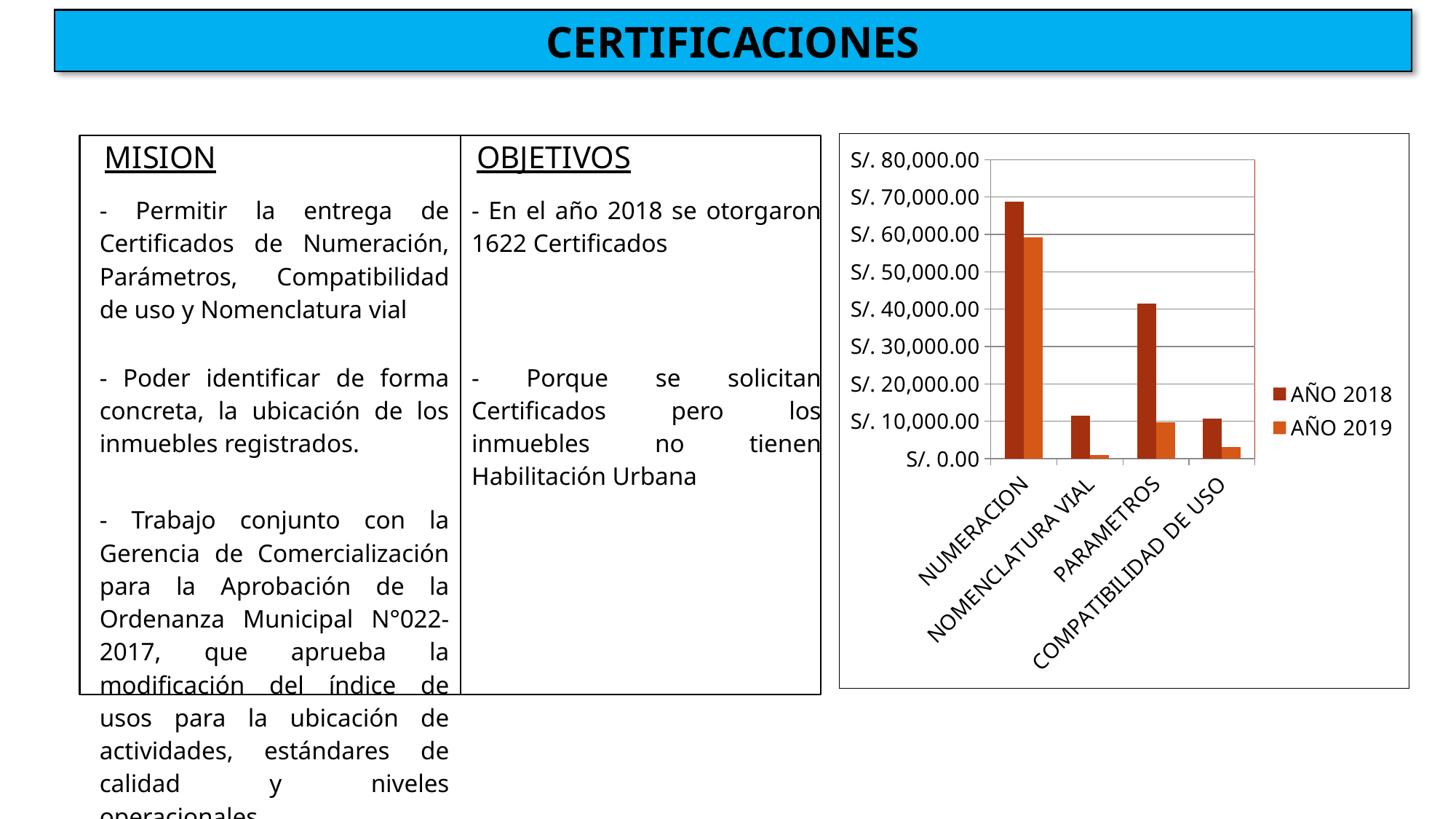
How many categories are shown on the x axis of the chart? 4 What are the two entries listed in the chart's legend? AÑO 2018 and AÑO 2019 Is the AÑO 2019 value for NOMENCLATURA VIAL greater or less than S/. 10,000.00? less Which category has the highest value for AÑO 2019? NUMERACION For NUMERACION, which series is larger, AÑO 2018 or AÑO 2019? AÑO 2018 Which category has the lowest value for AÑO 2019? NOMENCLATURA VIAL How many series does the chart's legend list? 2 Is the AÑO 2018 value for PARAMETROS greater or less than S/. 30,000.00? greater Is the AÑO 2018 value for NUMERACION greater or less than S/. 60,000.00? greater Which category has the highest value for AÑO 2018? NUMERACION For PARAMETROS, which series is larger, AÑO 2018 or AÑO 2019? AÑO 2018 What kind of chart is shown on the slide? bar chart